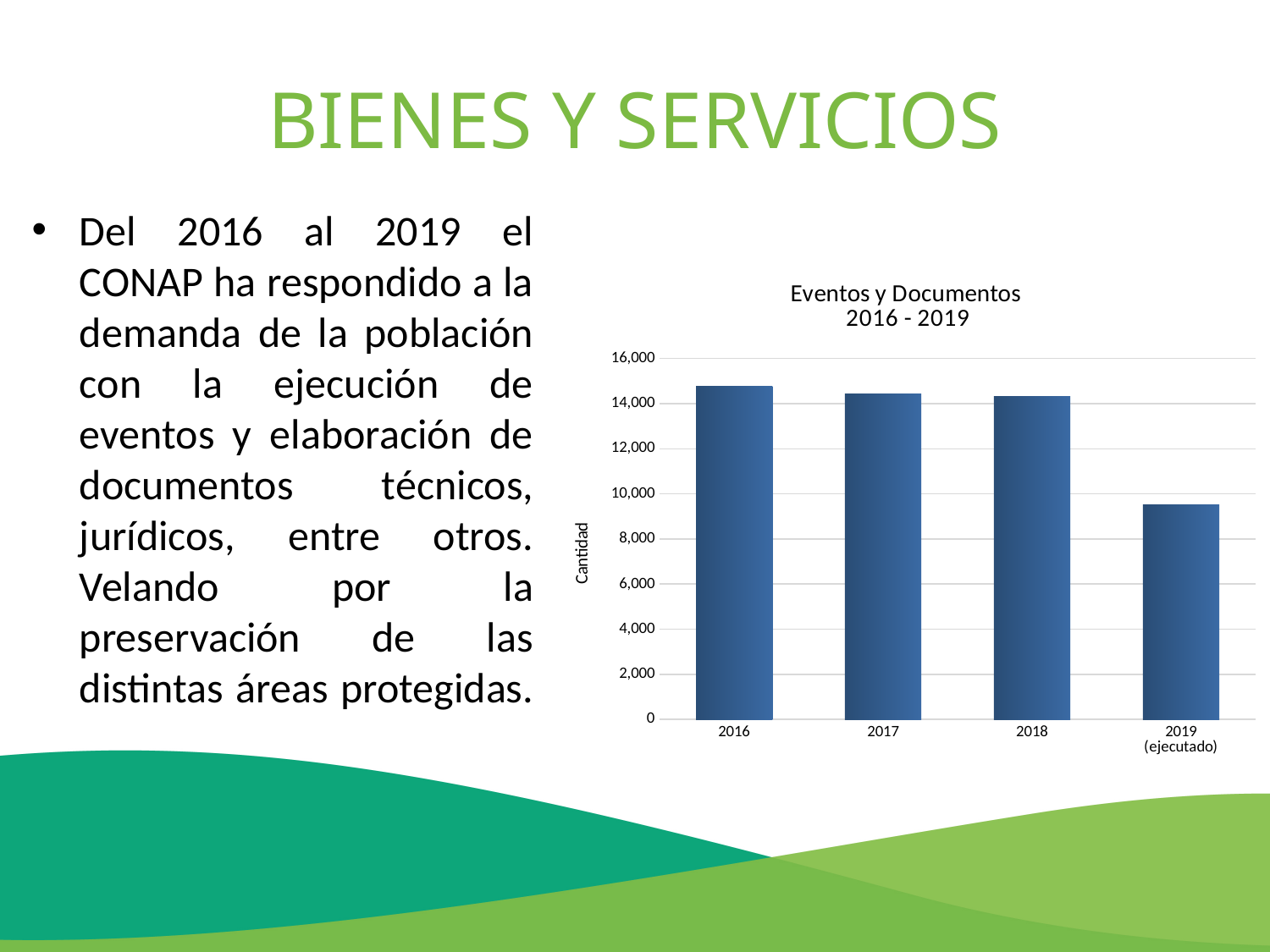
Which is larger, the value for 2017 or the value for 2019 (ejecutado)? 2017 What kind of chart is shown on the slide? bar chart Is the value for 2016 greater or less than 14,000? greater Which is larger, the value for 2016 or the value for 2019 (ejecutado)? 2016 Is the value for 2019 (ejecutado) greater or less than 10,000? less What is the label on the vertical axis of the chart? Cantidad Is the value for 2017 greater or less than 12,000? greater How many categories (years) are plotted in the chart? 4 Which year has the lowest value in the chart? 2019 (ejecutado) What is the title of the chart? Eventos y Documentos 2016 - 2019 Do the values generally rise or fall from 2016 to 2019 (ejecutado)? fall